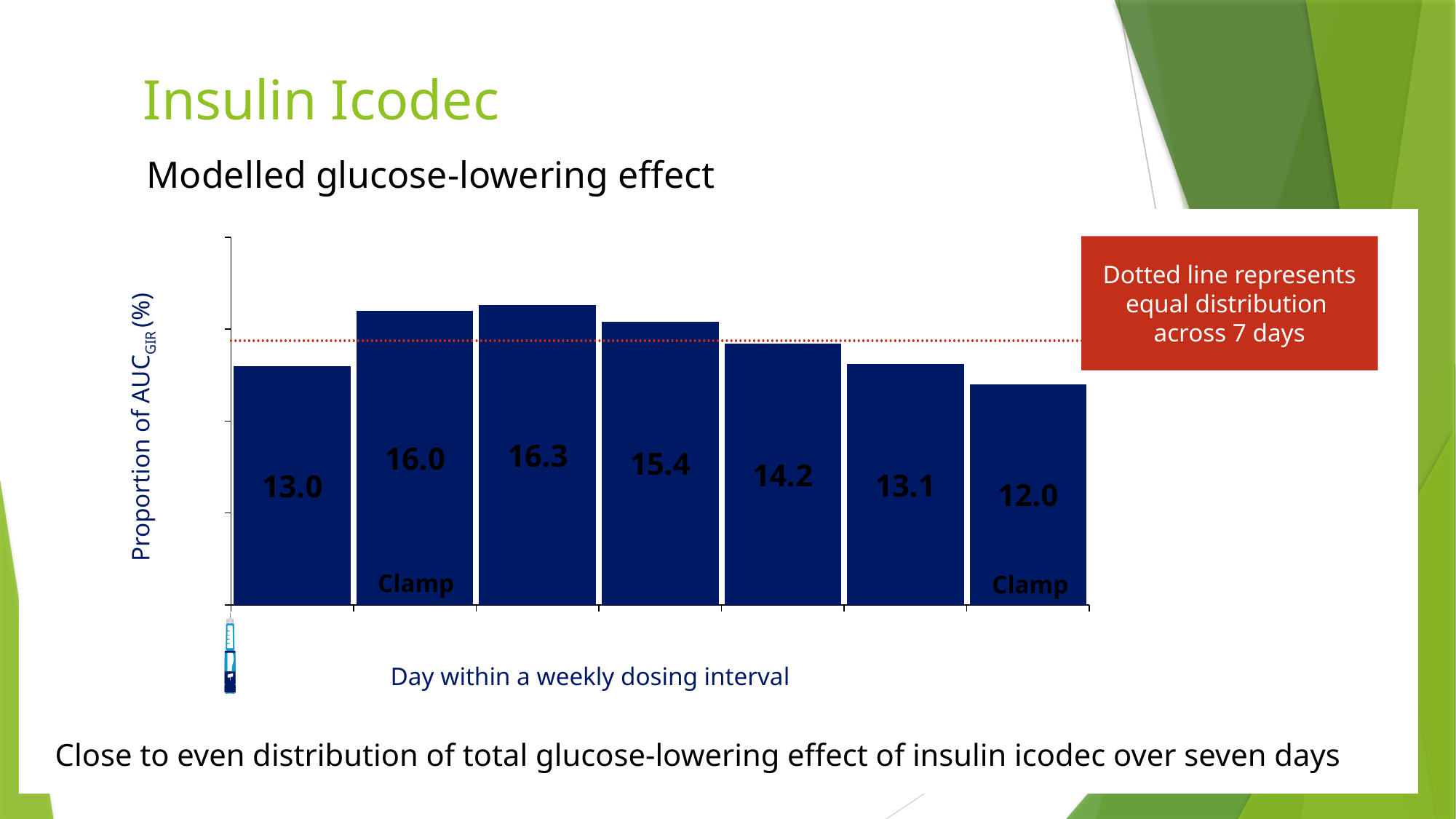
What is the value of the third bar in the chart? 16.3 What is the difference between the highest bar (16.3) and the lowest bar (12.0)? 4.3 According to the red box, what does the dotted line in the chart represent? Equal distribution across 7 days What is the value of the first bar in the chart? 13.0 Which is larger, the value of the second bar or the value of the fourth bar? The second bar (16.0) How many bars are shown in the chart? 7 What type of chart is shown on the slide? Bar chart What is the sum of all seven bar values in the chart? 100.0 Which bar has the highest value in the chart? The third bar (16.3) Which bar has the lowest value in the chart? The seventh bar (12.0) What is the value of the fifth bar in the chart? 14.2 What is the value of the last (seventh) bar in the chart? 12.0